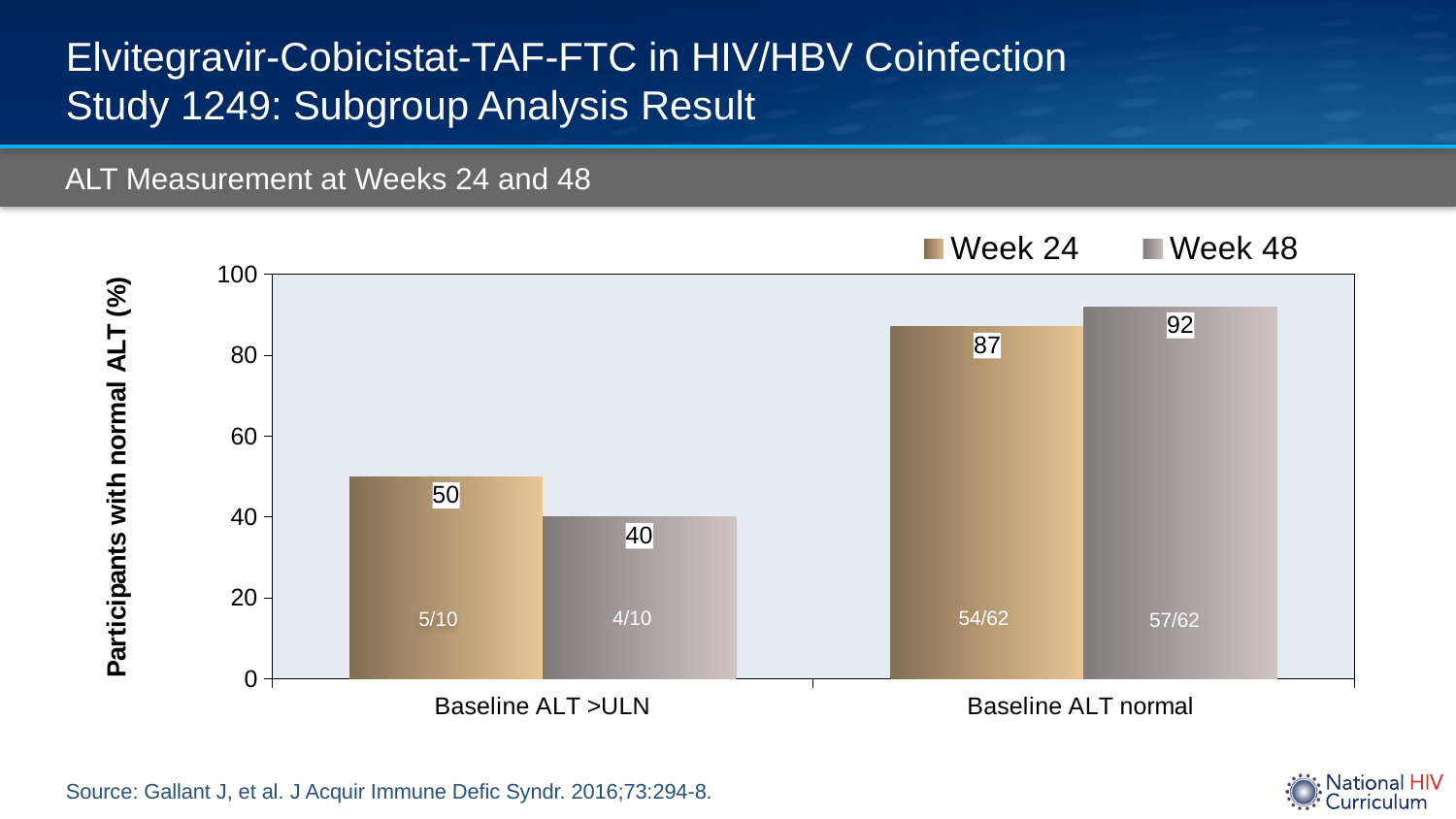
What is the difference between the Week 24 and Week 48 values for Baseline ALT >ULN? 10 What is the Week 24 value for Baseline ALT >ULN? 50 What fraction of participants is shown inside the Week 48 bar for Baseline ALT >ULN? 4/10 How many categories are shown on the x axis? 2 What is the Week 24 value for Baseline ALT normal? 87 Which is larger for Baseline ALT normal: the Week 24 value or the Week 48 value? Week 48 What is the Week 48 value for Baseline ALT normal? 92 Which bar has the lowest value on the chart? Week 48, Baseline ALT >ULN What kind of chart is shown on the slide? Bar chart Which bar has the highest value on the chart? Week 48, Baseline ALT normal How many series does the legend list? 2 What is the difference between the Week 48 and Week 24 values for Baseline ALT normal? 5